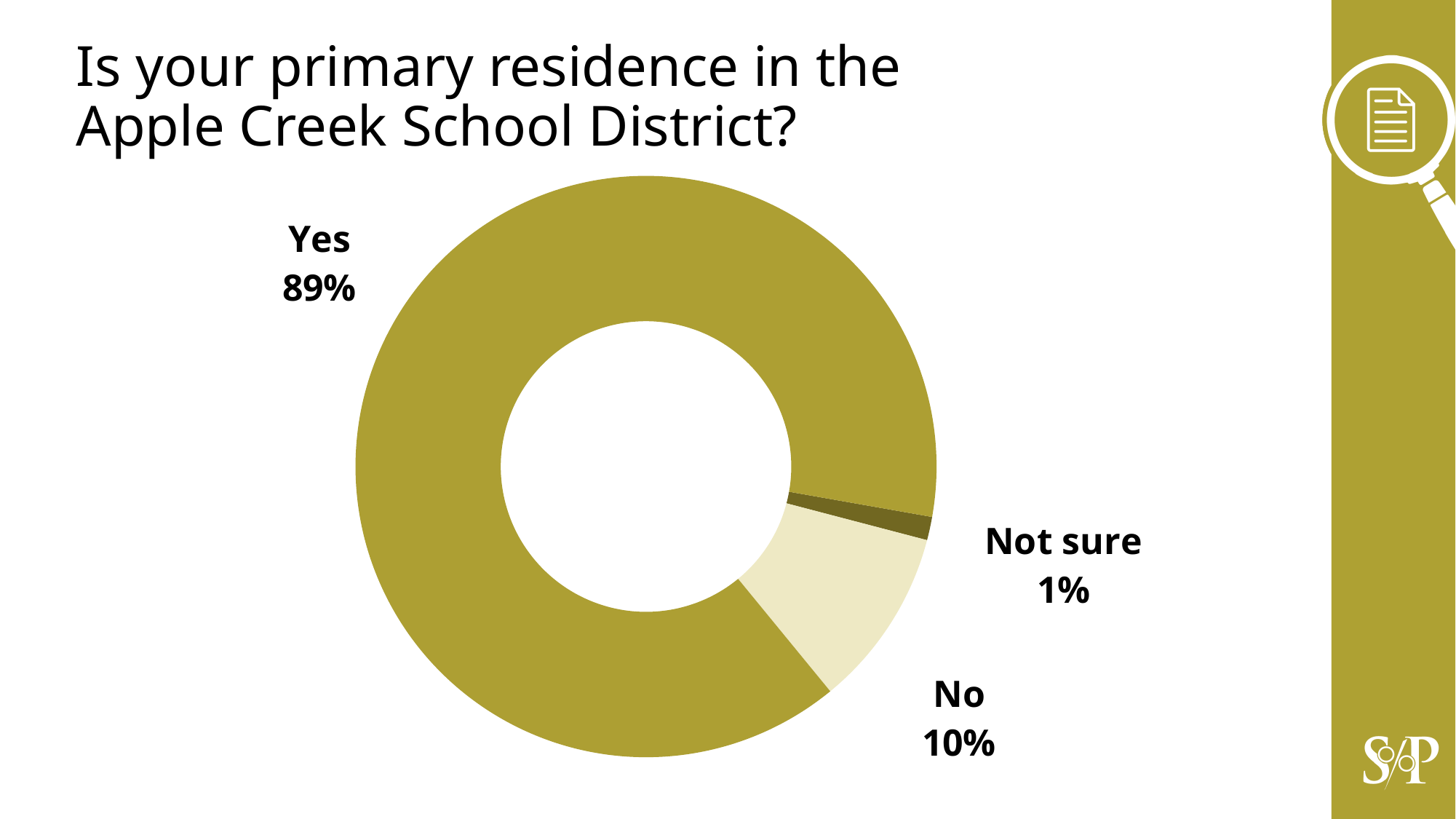
What is the difference in percentage points between the "Yes" and "No" responses? 79 How many response categories are shown in the chart? 3 Which response is larger, "No" or "Not sure"? No What percentage of respondents answered "Not sure"? 1% Which response has the smallest share of the chart? Not sure What is the title of the slide? Is your primary residence in the Apple Creek School District? What percentage of respondents answered "Yes"? 89% What is the difference in percentage points between the "No" and "Not sure" responses? 9 What percentage of respondents answered "No"? 10% What kind of chart is shown on the slide? Doughnut (pie) chart What is the combined share of the "No" and "Not sure" responses? 11% Which response has the largest share of the chart? Yes